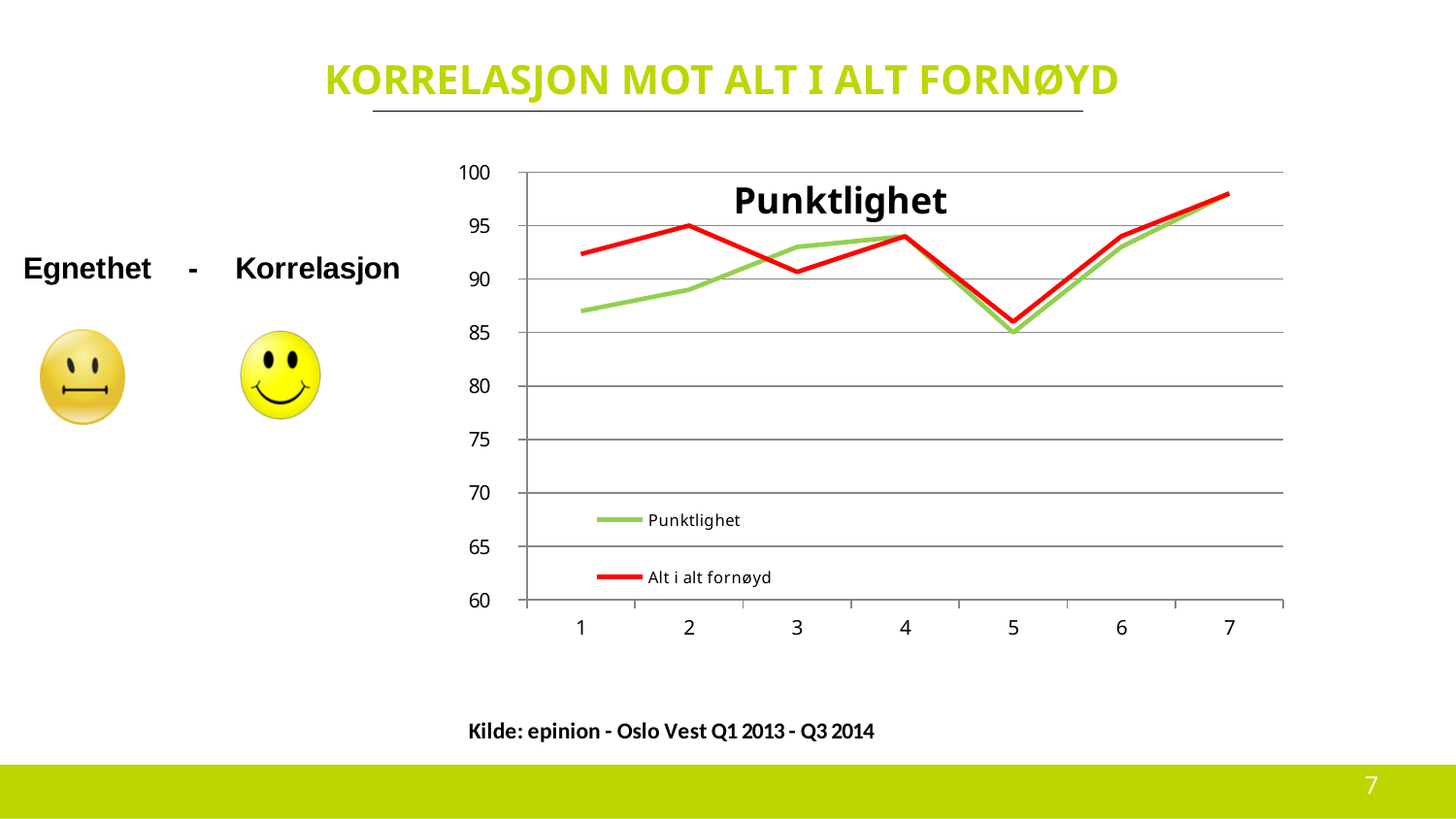
What is the title of the chart? Punktlighet At which x-axis point does the 'Alt i alt fornøyd' series reach its highest value? 7 Is the value for 'Alt i alt fornøyd' at point 7 greater or less than 95? greater Which colour is used for the 'Alt i alt fornøyd' series? red Is the value for 'Punktlighet' at point 1 greater or less than 90? less How many series does the chart's legend list? 2 At point 3, which series has the higher value, 'Punktlighet' or 'Alt i alt fornøyd'? Punktlighet At which x-axis point does the 'Punktlighet' series reach its lowest value? 5 At point 2, which series has the higher value, 'Punktlighet' or 'Alt i alt fornøyd'? Alt i alt fornøyd What kind of chart is shown on the slide? line chart Do the values of both series rise or fall from point 5 to point 7? rise How many points are plotted along the x axis for each series? 7